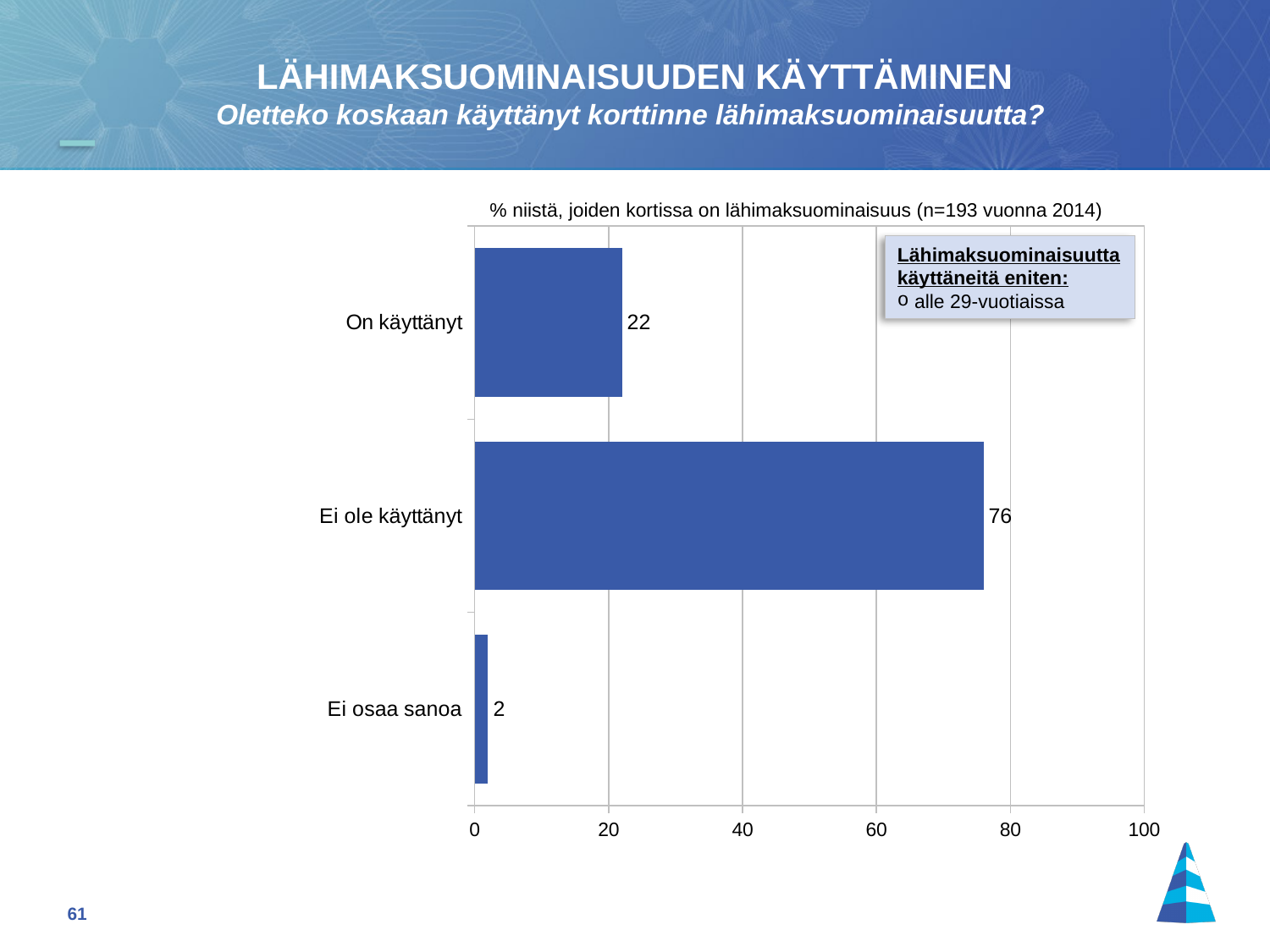
Which is larger, the value for "On käyttänyt" or the value for "Ei osaa sanoa"? On käyttänyt How many categories are shown in the chart? 3 What is the value for "On käyttänyt"? 22 What kind of chart is shown on the slide? bar chart Is the value for "Ei ole käyttänyt" greater or less than 60? greater Which category has the highest value? Ei ole käyttänyt What is the sample size (n) stated in the chart's subtitle? n=193 What is the value for "Ei ole käyttänyt"? 76 What is the maximum value shown on the x axis? 100 What is the difference between the values for "Ei ole käyttänyt" and "On käyttänyt"? 54 What is the value for "Ei osaa sanoa"? 2 Which category has the lowest value? Ei osaa sanoa